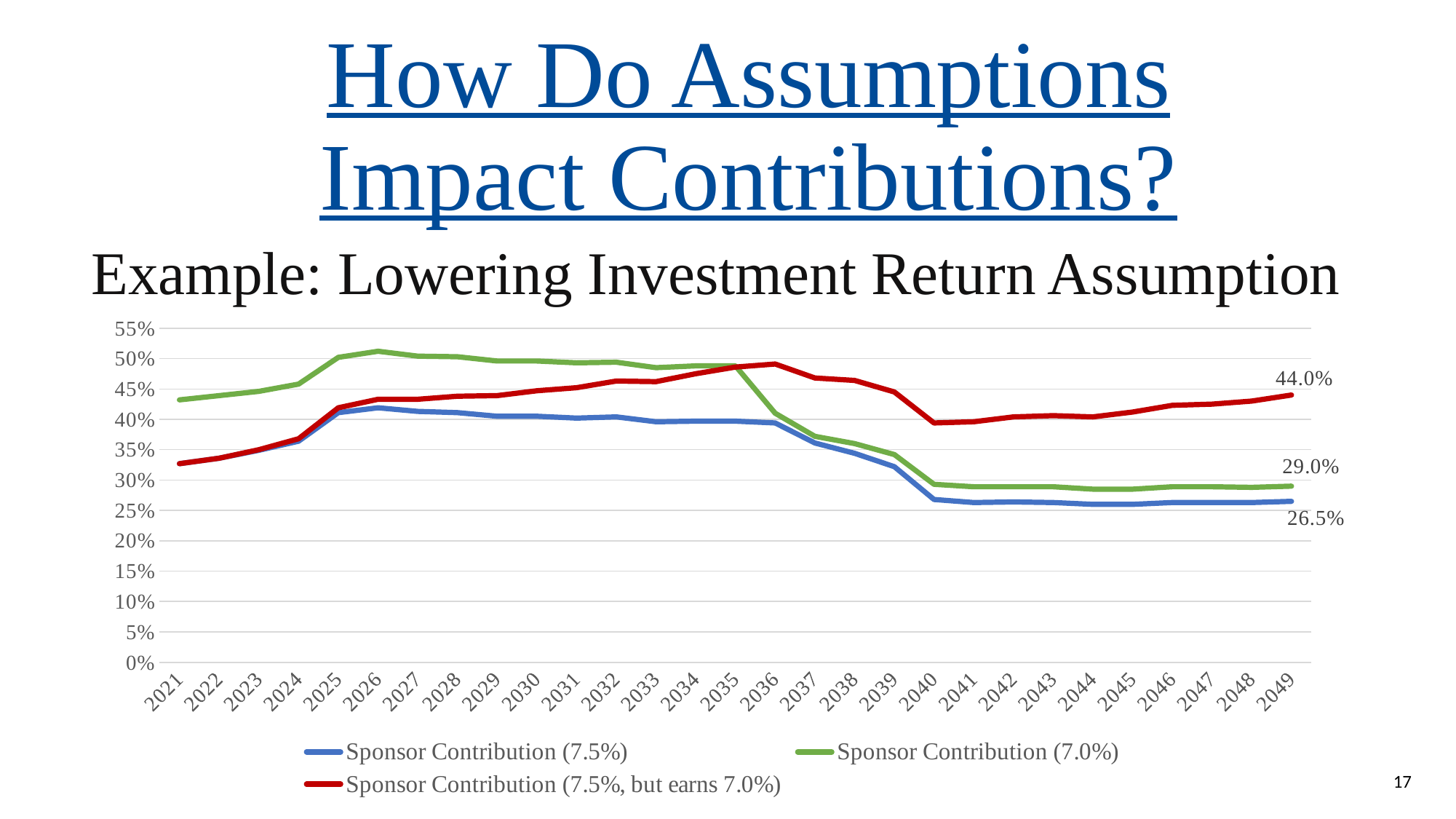
Does Sponsor Contribution (7.5%) rise or fall between 2036 and 2040? fall In 2049, what is the difference between Sponsor Contribution (7.5%, but earns 7.0%) and Sponsor Contribution (7.5%)? 17.5 percentage points What type of chart is shown on the slide? line chart What is the value of Sponsor Contribution (7.0%) in 2049? 29.0% What colour is the line for Sponsor Contribution (7.0%)? green Which series has the highest value in 2049? Sponsor Contribution (7.5%, but earns 7.0%) In 2049, which is higher: Sponsor Contribution (7.0%) or Sponsor Contribution (7.5%)? Sponsor Contribution (7.0%) What is the value of Sponsor Contribution (7.5%, but earns 7.0%) in 2049? 44.0% How many years are shown along the x axis? 29 How many series does the legend list? 3 What is the value of Sponsor Contribution (7.5%) in 2049? 26.5% Is the value for Sponsor Contribution (7.0%) in 2026 greater or less than 50%? greater